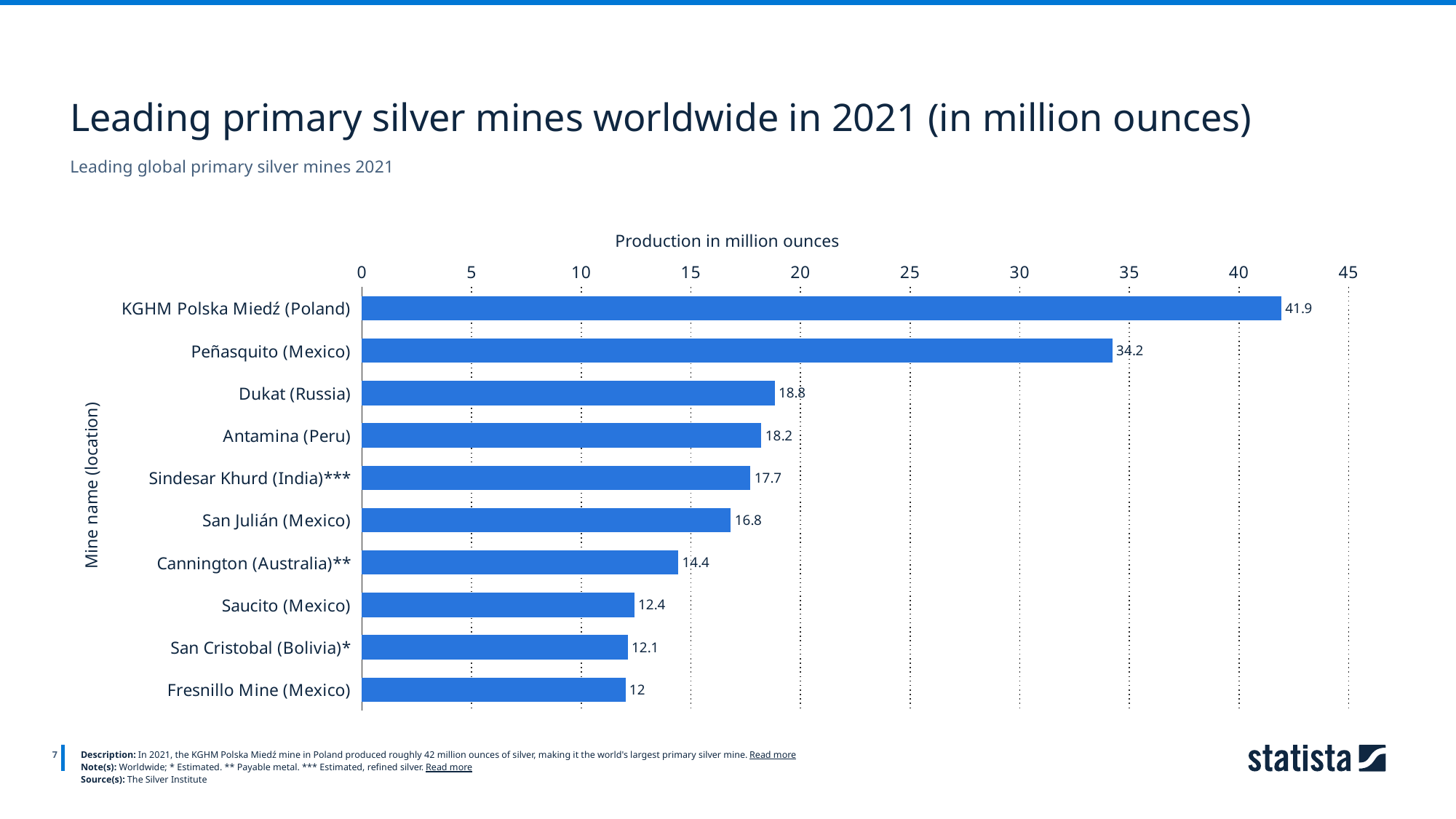
Which mine had the highest production in 2021? KGHM Polska Miedź (Poland) Which mine had the lowest production in 2021? Fresnillo Mine (Mexico) What type of chart is shown on the slide? Bar chart What is the difference in production between Dukat (Russia) and Saucito (Mexico)? 6.4 What was the production of the San Julián (Mexico) mine in 2021? 16.8 What is the difference in production between KGHM Polska Miedź (Poland) and Peñasquito (Mexico)? 7.7 How many mines are shown in the chart? 10 Is the production of Peñasquito (Mexico) greater or less than 30? greater Which mine had higher production, Antamina (Peru) or Sindesar Khurd (India)***? Antamina (Peru) What is the label of the horizontal axis of the chart? Production in million ounces What was the production of the KGHM Polska Miedź (Poland) mine in 2021? 41.9 What was the production of the Cannington (Australia)** mine in 2021? 14.4